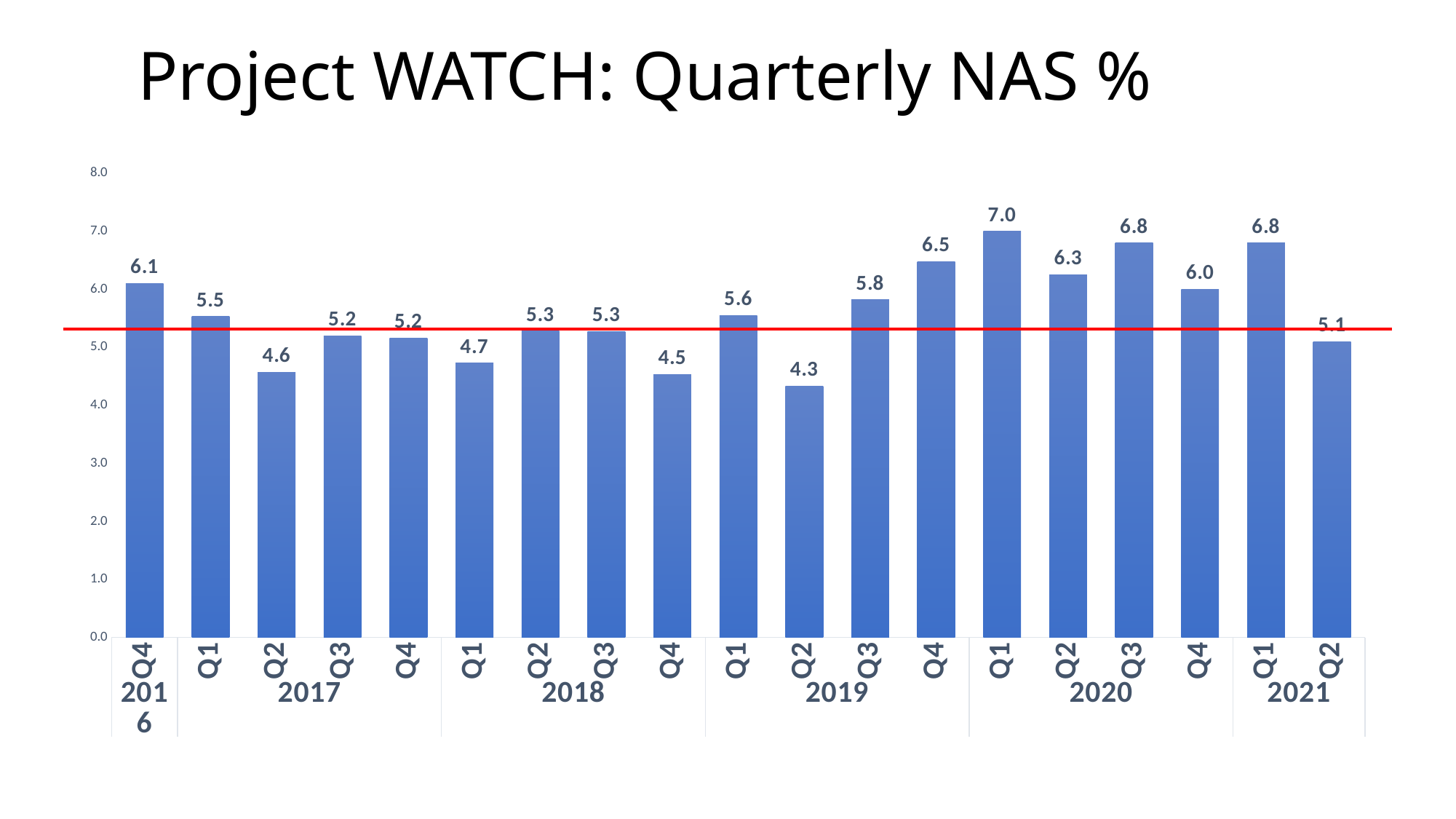
Which quarter has the highest value? Q1 2020 What is the difference between Q1 2020 and Q2 2019? 2.7 Which is larger, Q4 2019 or Q2 2020? Q4 2019 What is the value for Q1 2020? 7.0 Which quarter has the lowest value? Q2 2019 What is the value for Q2 2019? 4.3 What is the title of the chart? Project WATCH: Quarterly NAS % How many bars are plotted in the chart? 19 Do the values rise or fall from Q2 2019 to Q1 2020? rise Is the value for Q3 2020 greater or less than 6.0? greater What is the value for Q4 2016? 6.1 What kind of chart is shown? bar chart